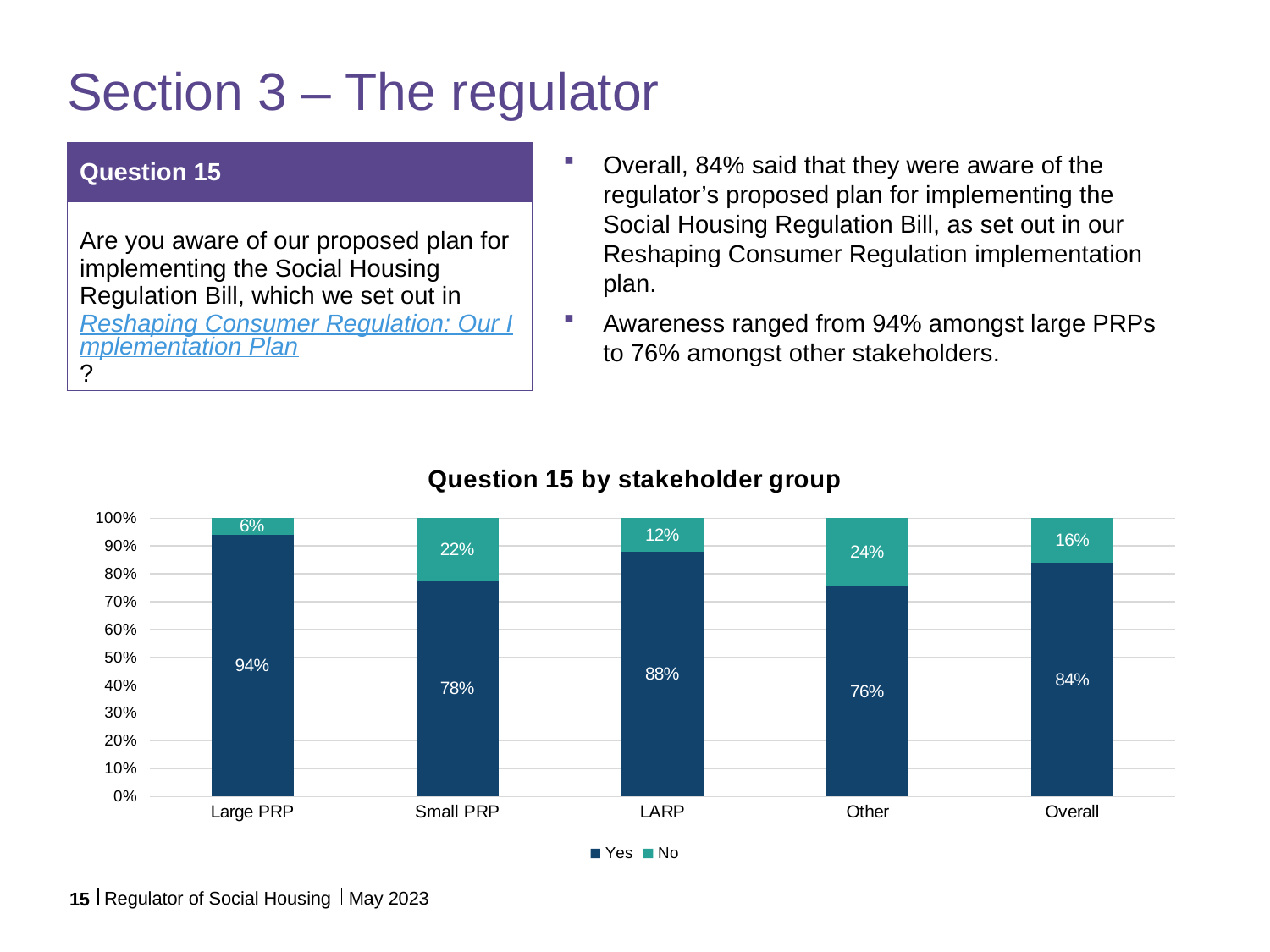
What percentage of Other stakeholders answered No? 24% What is the Yes value for LARP? 88% What is the difference between the Yes percentage for Large PRP and for Other? 18% What is the title of the chart? Question 15 by stakeholder group Which stakeholder group has the highest Yes percentage? Large PRP How many series does the legend list? 2 What percentage of Large PRP respondents answered Yes? 94% Which has a larger No percentage, Small PRP or LARP? Small PRP Which stakeholder group has the lowest Yes percentage? Other What is the No value for Small PRP? 22% How many stakeholder groups are shown on the x axis? 5 What type of chart is shown? Stacked bar chart